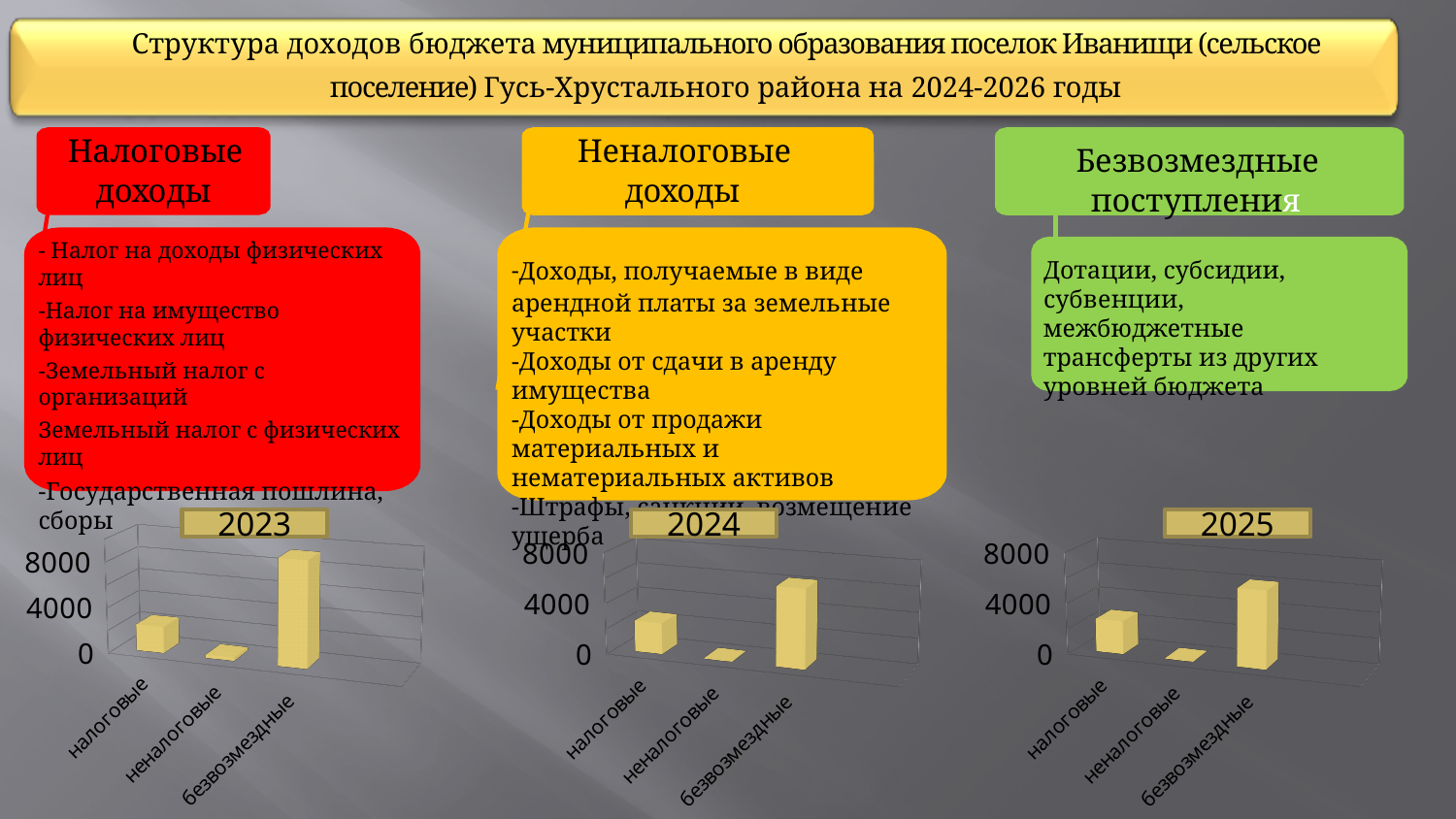
In the chart titled 2024, which category has the highest value? безвозмездные What kind of chart is the chart titled 2024? bar chart In the chart titled 2023, is the value for безвозмездные greater or less than 4000? greater In the chart titled 2023, which category has the lowest value? неналоговые In the chart titled 2023, which category has the highest value? безвозмездные What is the title of the chart on the right of the slide? 2025 How many categories are shown in the chart titled 2025? 3 In the chart titled 2025, which is larger, налоговые or неналоговые? налоговые In the chart titled 2024, is the value for безвозмездные greater or less than 4000? greater In the chart titled 2024, which category has the lowest value? неналоговые In the chart titled 2023, is the value for налоговые greater or less than 4000? less